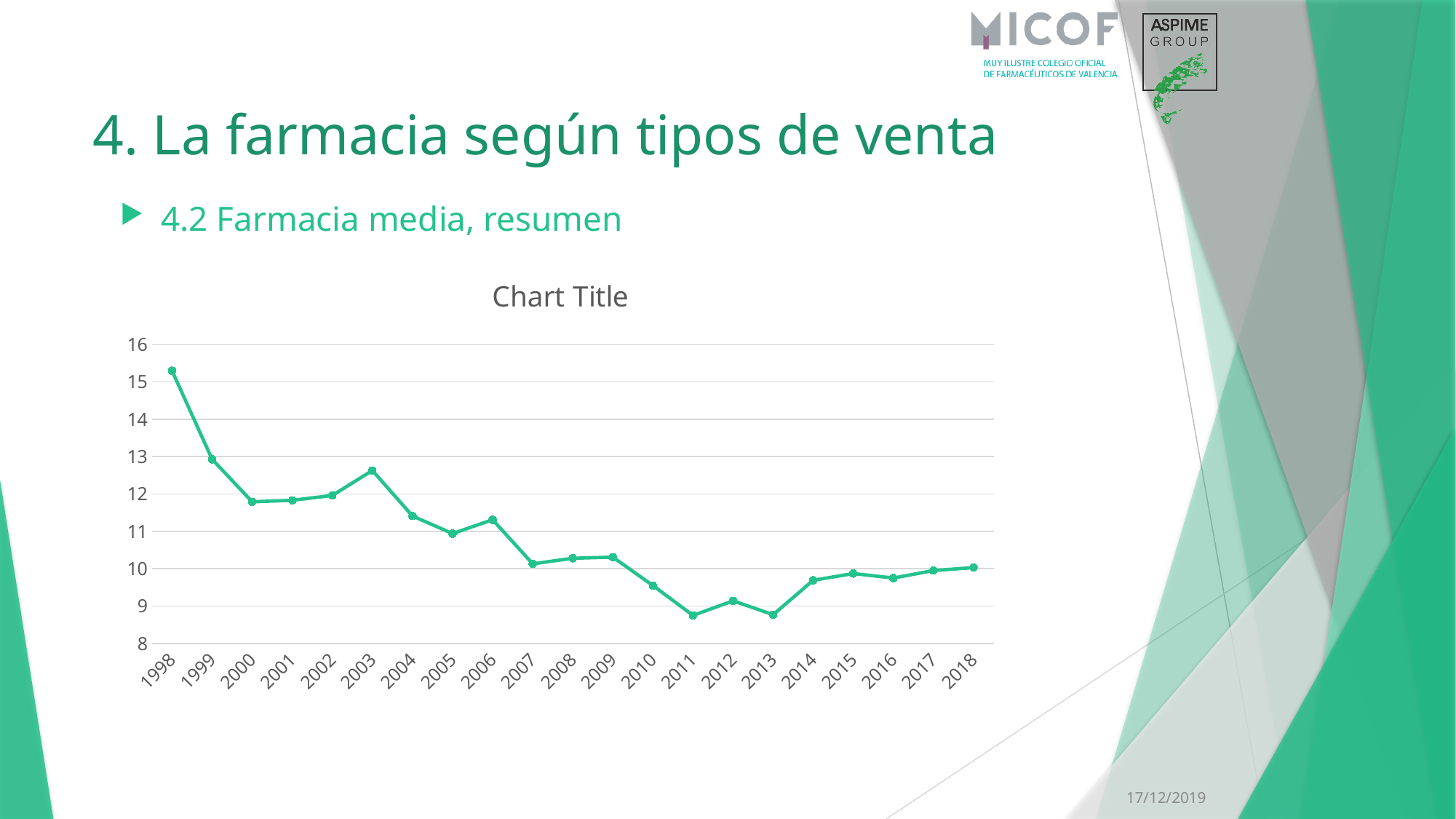
What kind of chart is shown on the slide? line chart What is the title shown above the chart? Chart Title Which year has the larger value, 2011 or 2012? 2012 Is the value for 2003 greater or less than 12? greater Is the value for 1998 greater or less than 15? greater Is the value for 2000 greater or less than 12? less Which year has the larger value, 2003 or 2004? 2003 Overall, do the values rise or fall from 1998 to 2018? fall Which year has the highest value in the chart? 1998 How many years are plotted along the x axis of the chart? 21